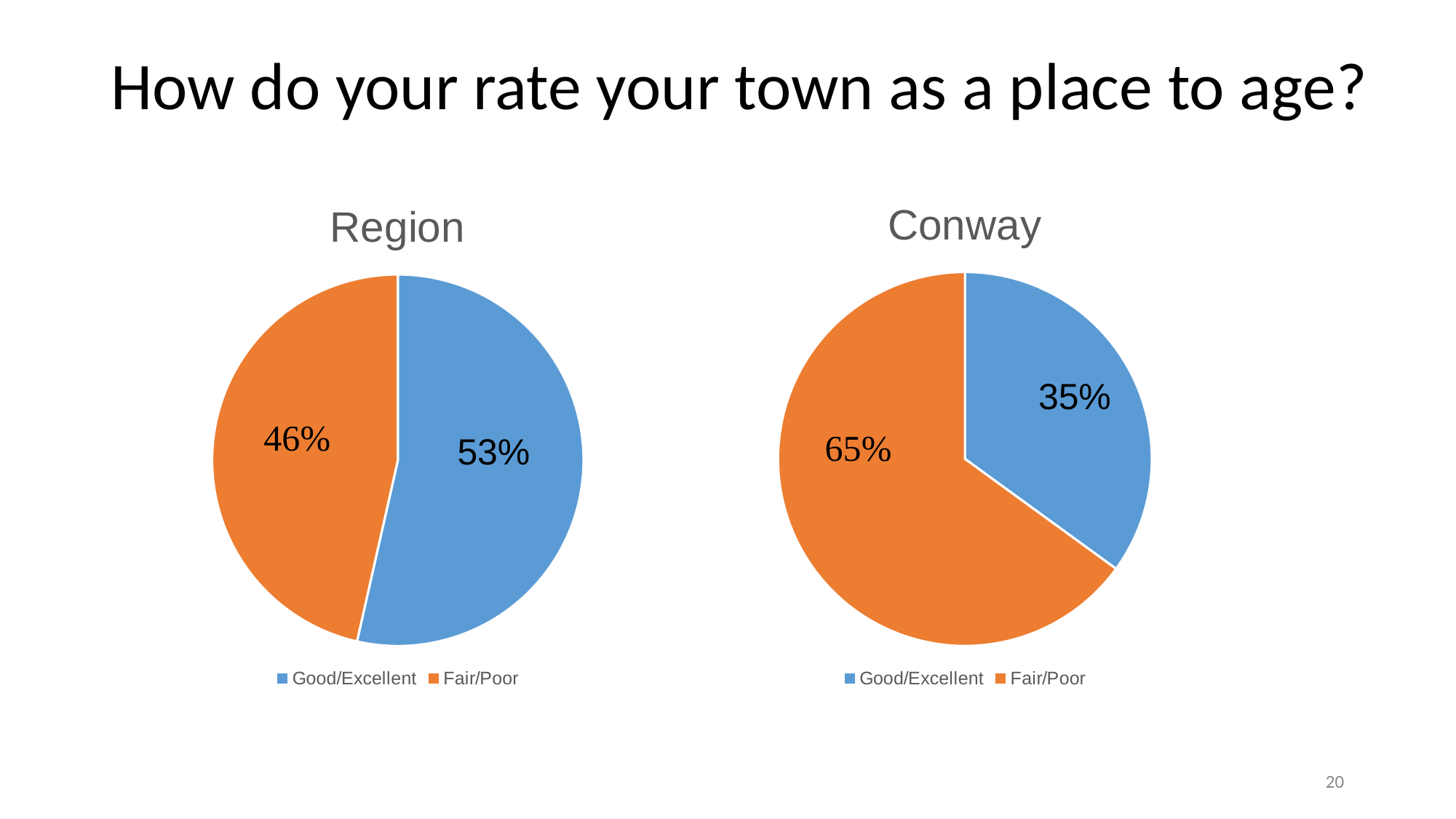
In the Conway chart, what colour is the Fair/Poor slice? Orange In the Conway chart, what is the difference between the Fair/Poor and Good/Excellent percentages? 30% What kind of chart is the Conway chart? Pie chart In the Region chart, which category has the largest slice? Good/Excellent In the Region chart, what percentage is shown for Good/Excellent? 53% Which is larger: the Good/Excellent share in the Region chart or the Good/Excellent share in the Conway chart? Region In the Conway chart, which category has the largest slice? Fair/Poor In the Conway chart, what percentage is shown for Fair/Poor? 65% In the Conway chart, what percentage is shown for Good/Excellent? 35% In the Region chart, what percentage is shown for Fair/Poor? 46% In the Conway chart, which category has the smallest slice? Good/Excellent How many categories does the legend of the Region chart list? 2